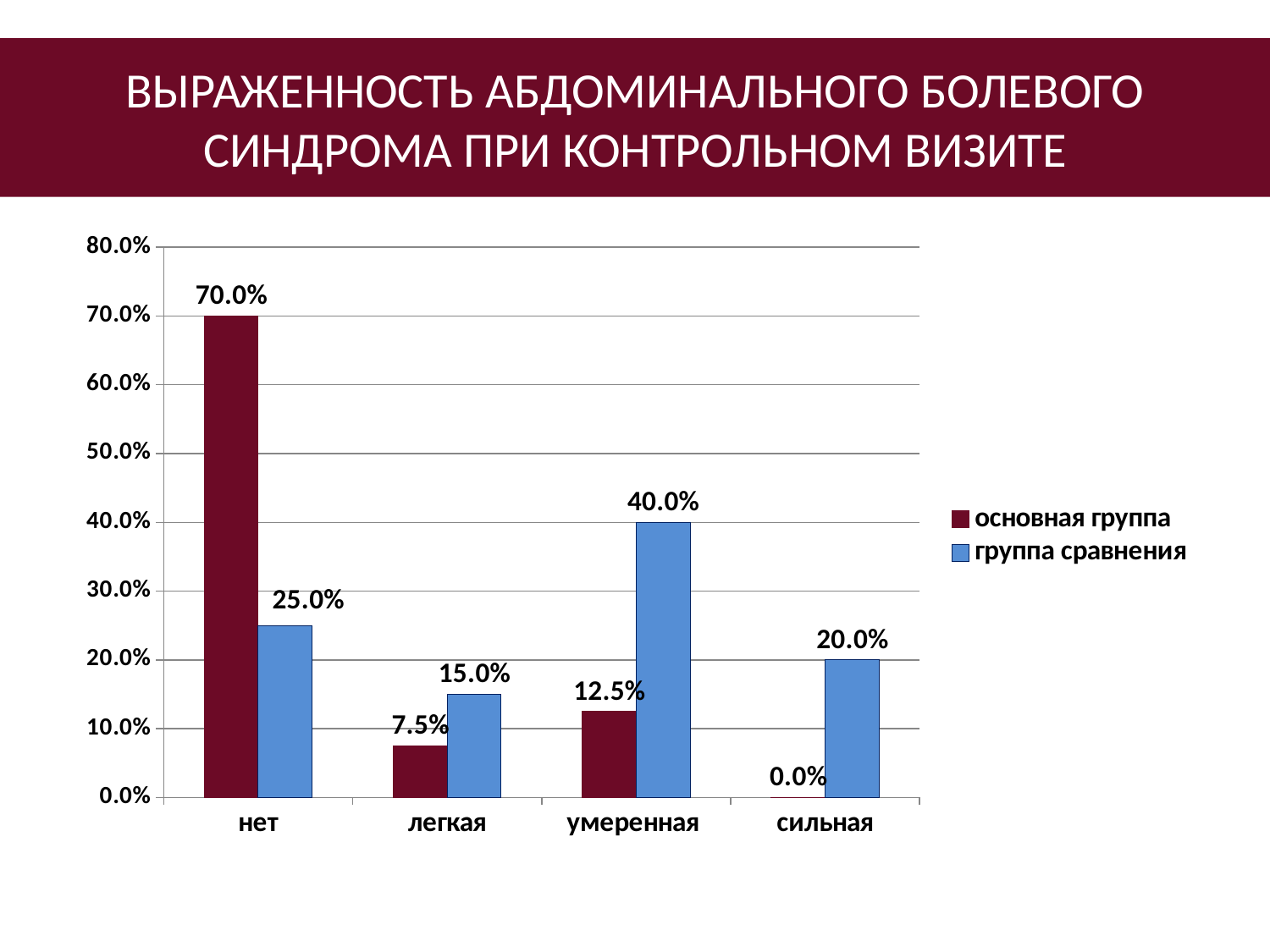
What is the value for "основная группа" in the "сильная" category? 0.0% Which category has the lowest value for "группа сравнения"? легкая Which category has the highest value for "основная группа"? нет What kind of chart is shown on the slide? bar chart What is the difference between "основная группа" and "группа сравнения" in the "нет" category? 45.0% Which series has the larger value in the "умеренная" category? группа сравнения What is the value for "группа сравнения" in the "умеренная" category? 40.0% How many series does the legend list? 2 How many categories are shown on the x axis? 4 What colour are the bars for "группа сравнения"? blue What is the value for "основная группа" in the "нет" category? 70.0% What is the value for "группа сравнения" in the "легкая" category? 15.0%